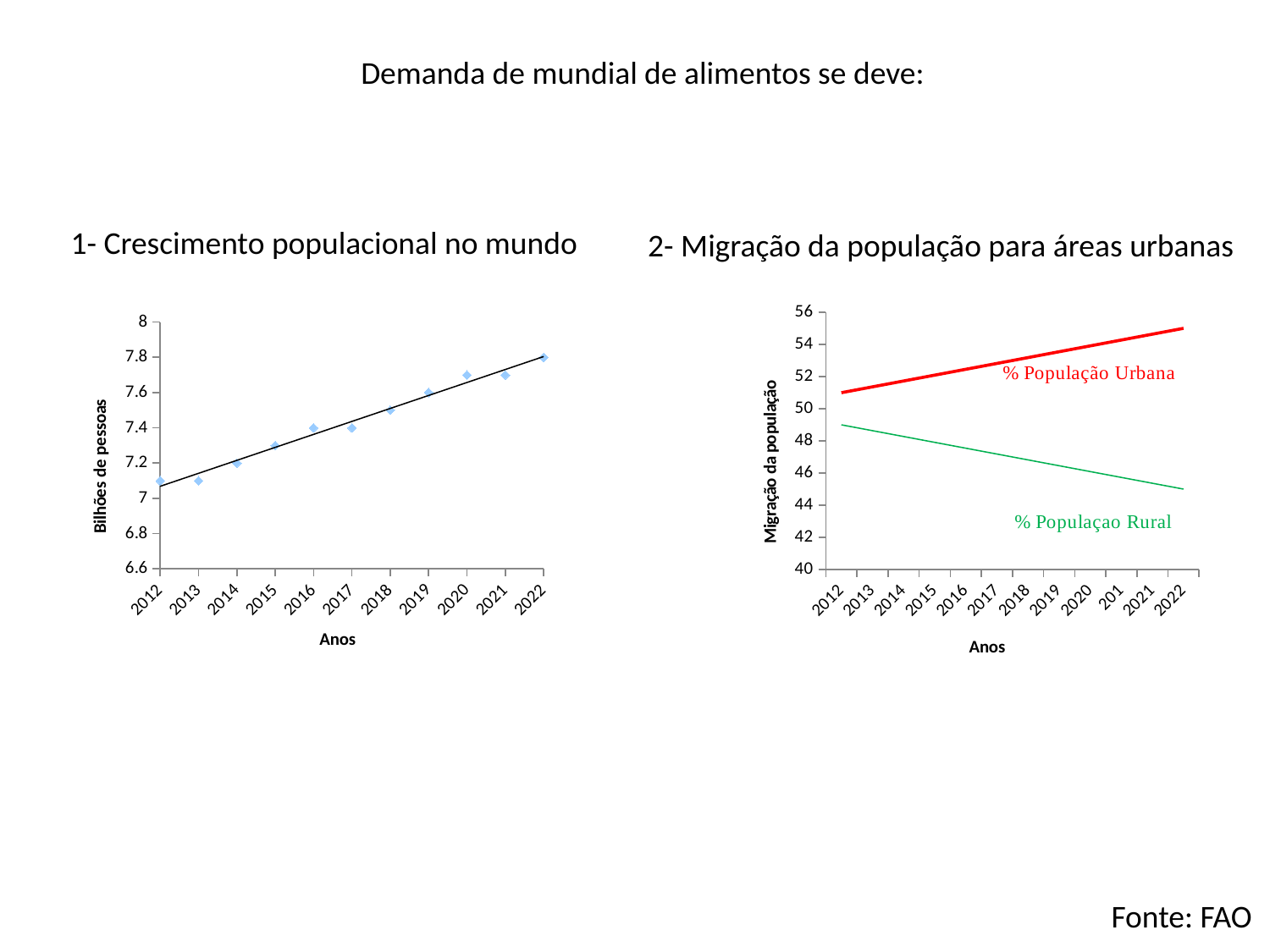
In the left chart, '1- Crescimento populacional no mundo', do the values rise or fall from 2012 to 2022? rise In the left chart, '1- Crescimento populacional no mundo', how many years are shown on the x axis? 11 In the left chart, '1- Crescimento populacional no mundo', is the value for 2022 greater or less than 7.6? greater In the right chart, '2- Migração da população para áreas urbanas', is the '% População Urbana' value for 2022 greater or less than 54? greater In the right chart, '2- Migração da população para áreas urbanas', what colour is the '% População Urbana' line? red What kind of chart is the right chart, '2- Migração da população para áreas urbanas'? line chart In the right chart, '2- Migração da população para áreas urbanas', does the '% Populaçao Rural' line rise or fall from 2012 to 2022? fall In the right chart, '2- Migração da população para áreas urbanas', does the '% População Urbana' line rise or fall from 2012 to 2022? rise In the left chart, '1- Crescimento populacional no mundo', which year has the highest value? 2022 In the right chart, '2- Migração da população para áreas urbanas', how many series are plotted? 2 In the left chart, '1- Crescimento populacional no mundo', is the value for 2012 greater or less than 7.2? less What kind of chart is the left chart, '1- Crescimento populacional no mundo'? scatter chart with a trend line